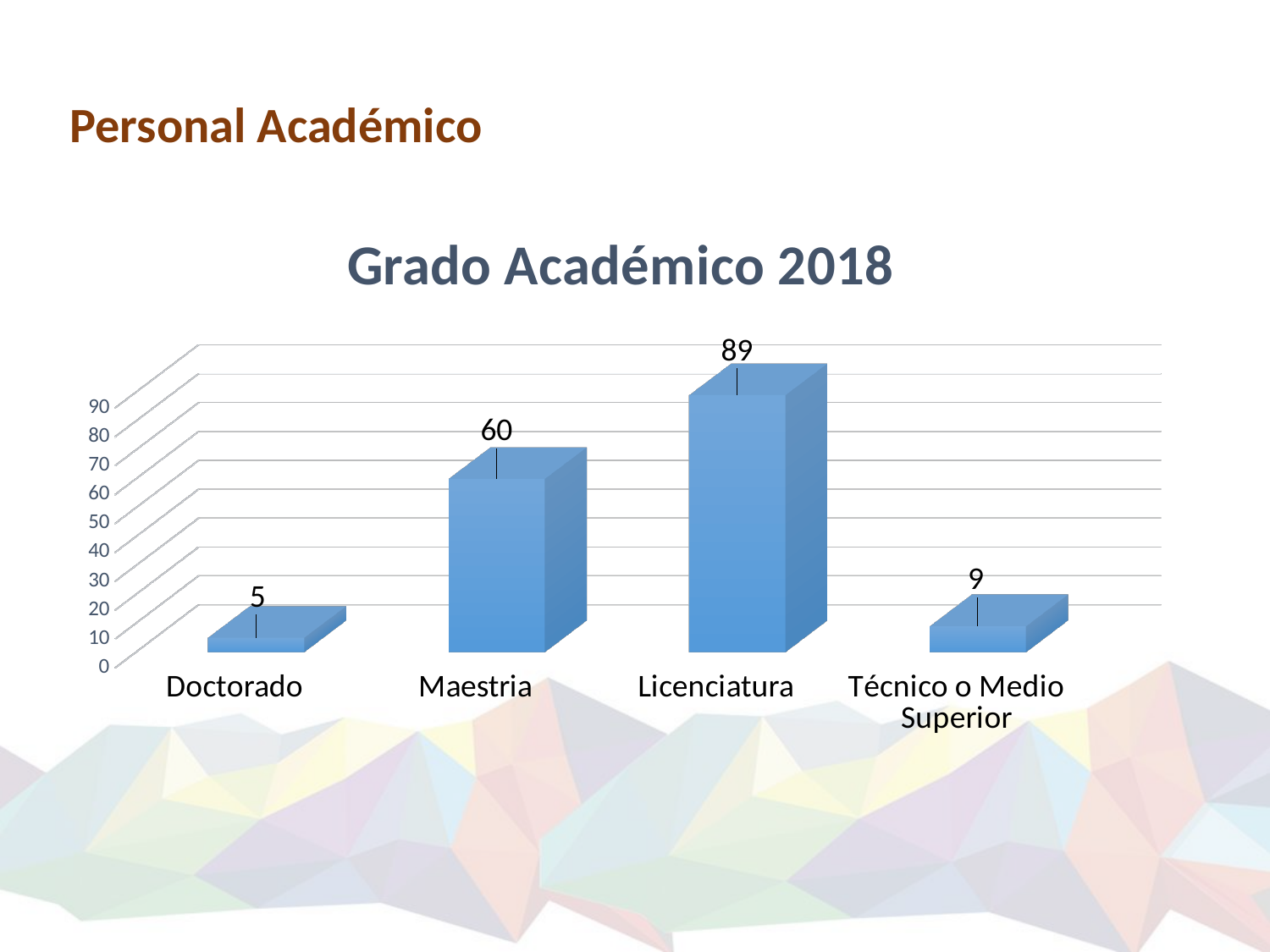
Which category has the lowest value? Doctorado What is the value for Maestria? 60 What kind of chart is shown on the slide? Bar chart What is the value for Técnico o Medio Superior? 9 What is the value for Doctorado? 5 Which is larger, the value for Maestria or the value for Técnico o Medio Superior? Maestria What is the value for Licenciatura? 89 What is the difference between the values for Técnico o Medio Superior and Doctorado? 4 What is the difference between the values for Licenciatura and Maestria? 29 What is the title of the chart? Grado Académico 2018 How many categories are shown in the chart? 4 Which category has the highest value? Licenciatura